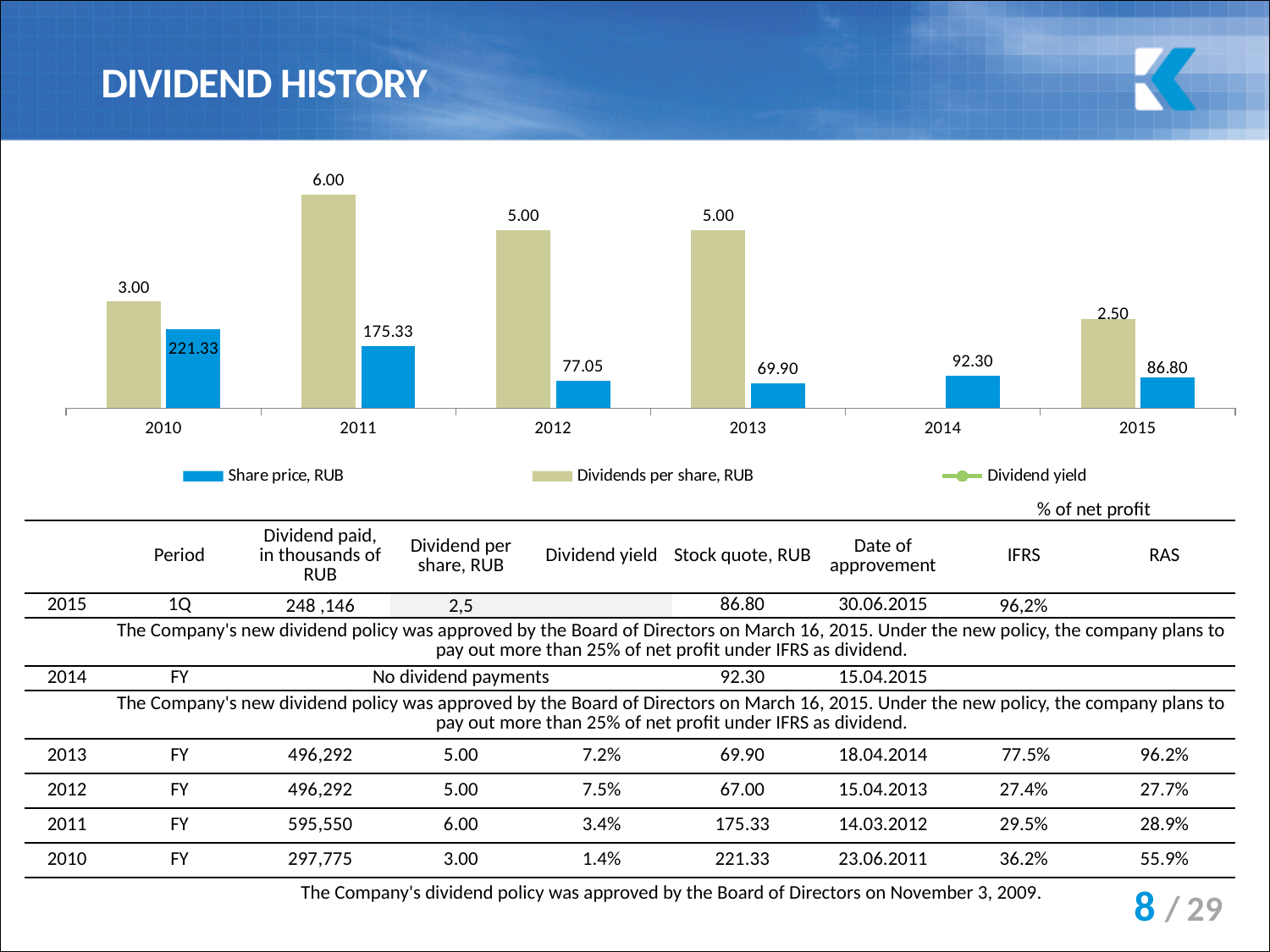
What type of chart is used on the slide? Bar chart What is the difference between the share price, RUB, in 2010 and in 2011 in the chart? 46.00 How many series does the chart legend list? 3 Is the share price, RUB, higher in 2014 or in 2015 in the chart? 2014 Which year has the lowest share price, RUB, in the chart? 2013 How many years are shown on the x axis of the chart? 6 What dividend per share, RUB, is shown for 2015 in the chart? 2.50 Which year has the highest dividends per share, RUB, in the chart? 2011 What share price, RUB, is labelled for 2010 in the chart? 221.33 Does the share price, RUB, rise or fall from 2010 to 2013 in the chart? Fall What is the share price, RUB, value shown for 2014 in the chart? 92.30 What is the dividend per share, RUB, shown for 2011 in the chart? 6.00